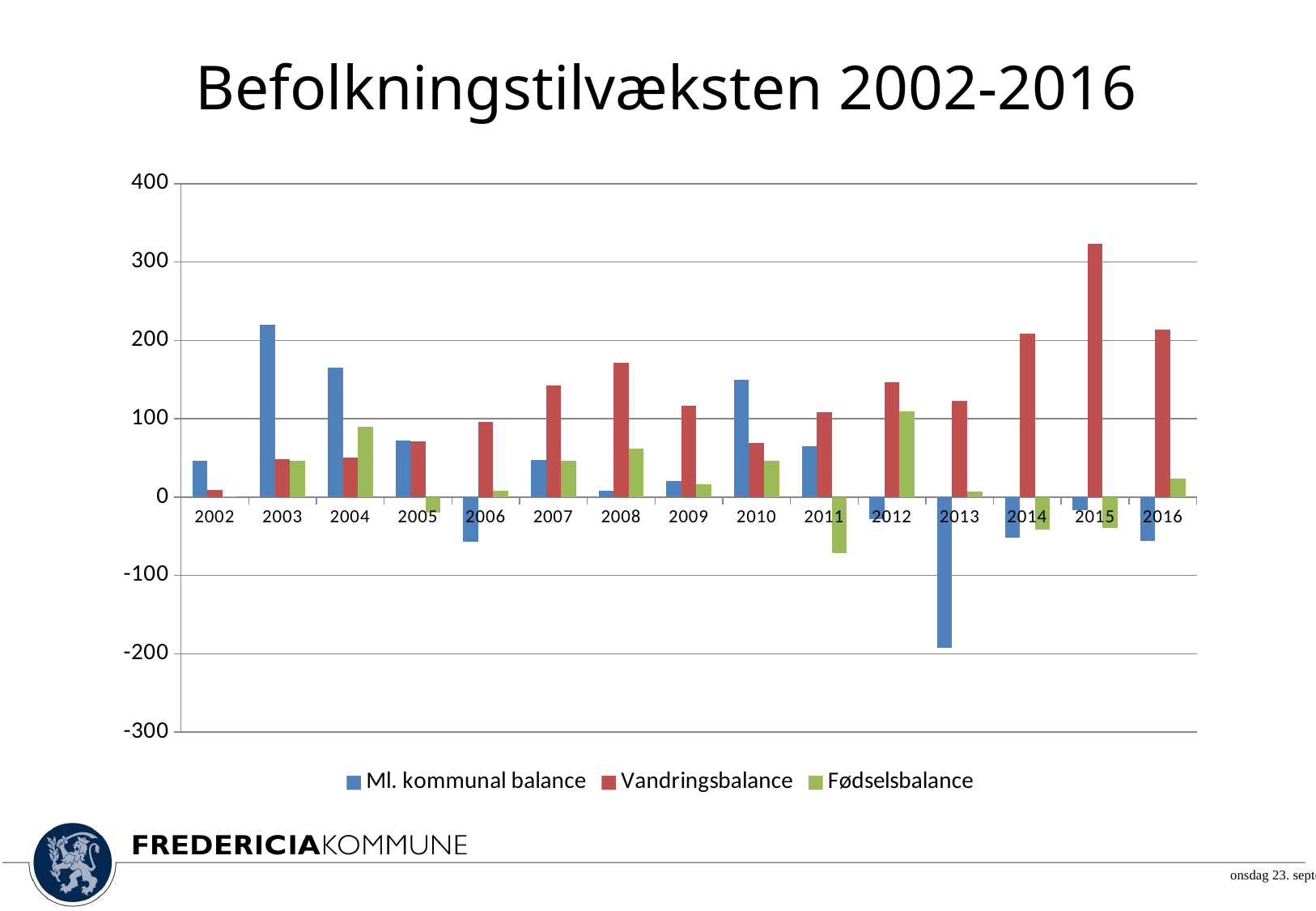
Is the value for Ml. kommunal balance in 2010 greater or less than 100? greater What is the title of the chart? Befolkningstilvæksten 2002-2016 In which year is Ml. kommunal balance lowest? 2013 What kind of chart is shown on the slide? bar chart In which year is Ml. kommunal balance highest? 2003 Is the value for Ml. kommunal balance in 2013 greater or less than -100? less Is the value for Vandringsbalance in 2015 greater or less than 300? greater In which year is Fødselsbalance lowest? 2011 How many series does the legend list? 3 In 2008, which is larger: Vandringsbalance or Ml. kommunal balance? Vandringsbalance In which year is Vandringsbalance highest? 2015 How many years are shown on the x axis? 15